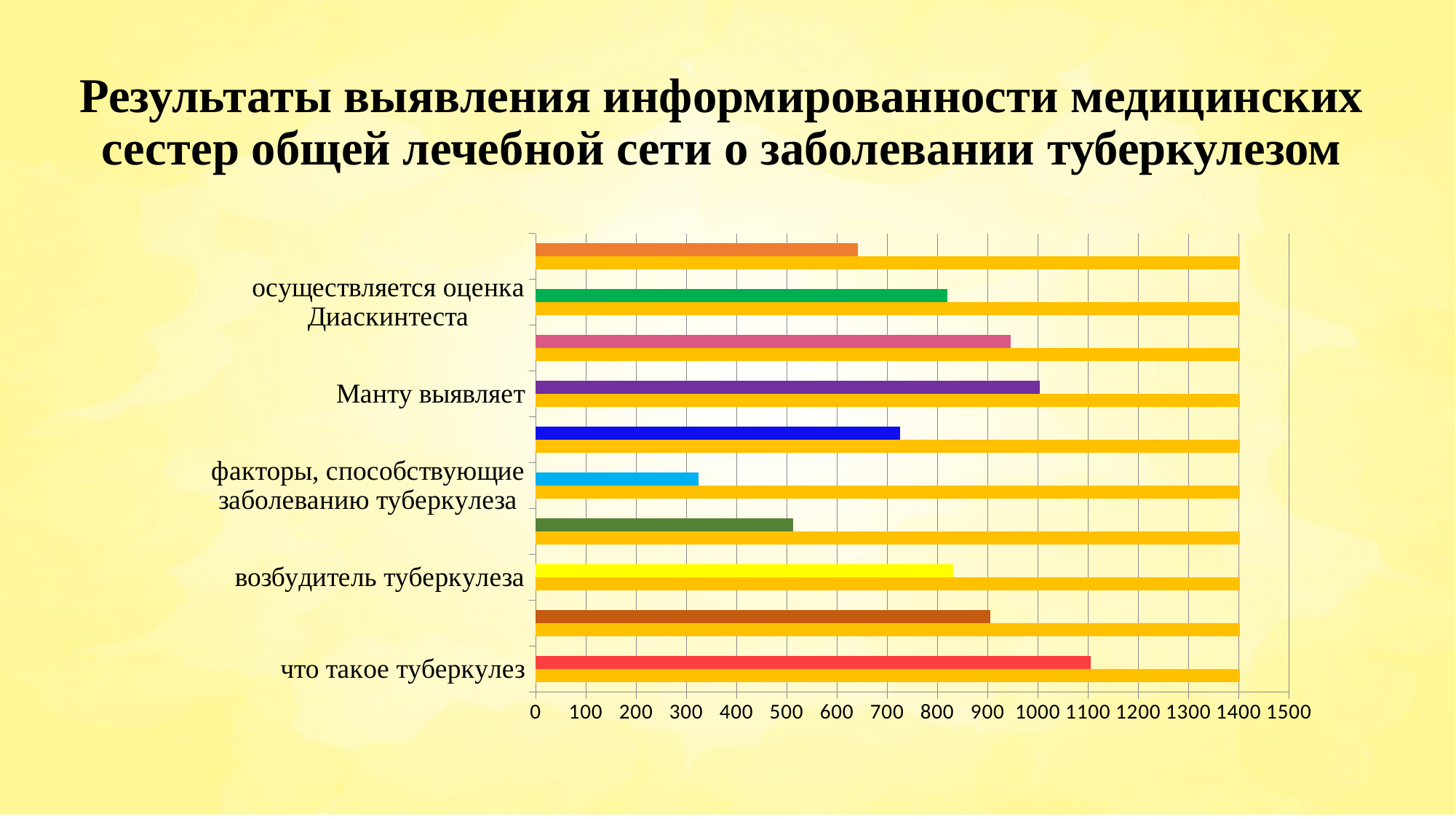
Is the value of the green bar for "осуществляется оценка Диаскинтеста" greater or less than 900? less Is the value of the yellow bar for "возбудитель туберкулеза" greater or less than 900? less Is the value of the red bar for "что такое туберкулез" greater or less than 1000? greater Among the labelled categories, which has the shortest coloured (non-orange) bar? факторы, способствующие заболеванию туберкулеза How many category labels are shown on the vertical axis of the chart? 5 Among the labelled categories, which has the longest coloured (non-orange) bar? что такое туберкулез What is the maximum value shown on the horizontal axis? 1500 What kind of chart is shown on the slide? bar chart Which has the larger coloured bar: "что такое туберкулез" or "Манту выявляет"? что такое туберкулез